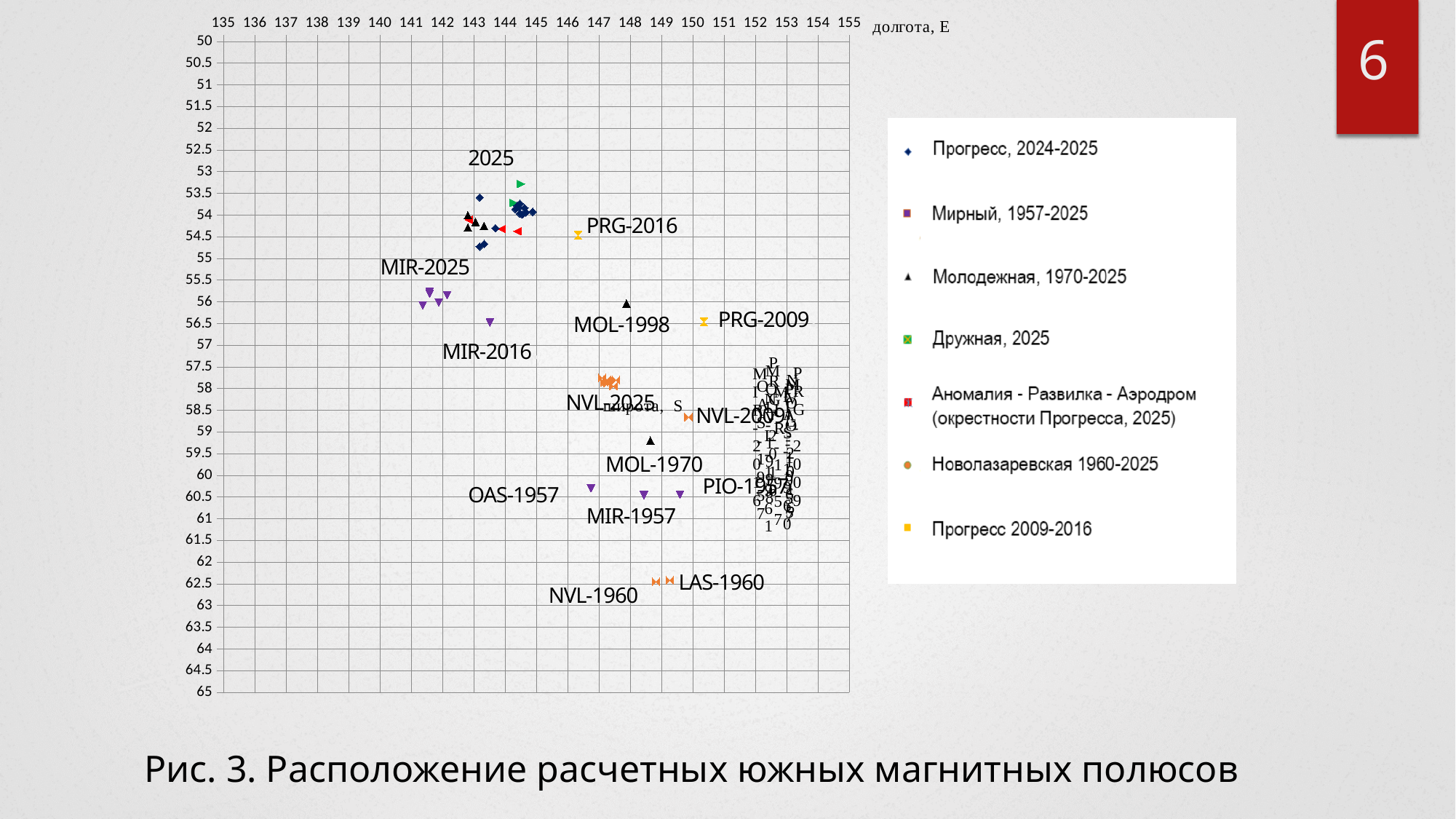
Is the latitude value for the point labelled PRG-2016 greater or less than 55? less Which point has the larger latitude value, LAS-1960 or PRG-2016? LAS-1960 How many series does the legend list? 7 Is the latitude value for the point labelled NVL-1960 greater or less than 62? greater Is the latitude value for the point labelled MOL-1998 greater or less than 56.5? less What is the caption of the figure below the chart? Рис. 3. Расположение расчетных южных магнитных полюсов What is the label of the horizontal axis of the chart? долгота, E What is the lowest longitude tick shown on the horizontal axis? 135 What kind of chart is shown on the slide? scatter chart